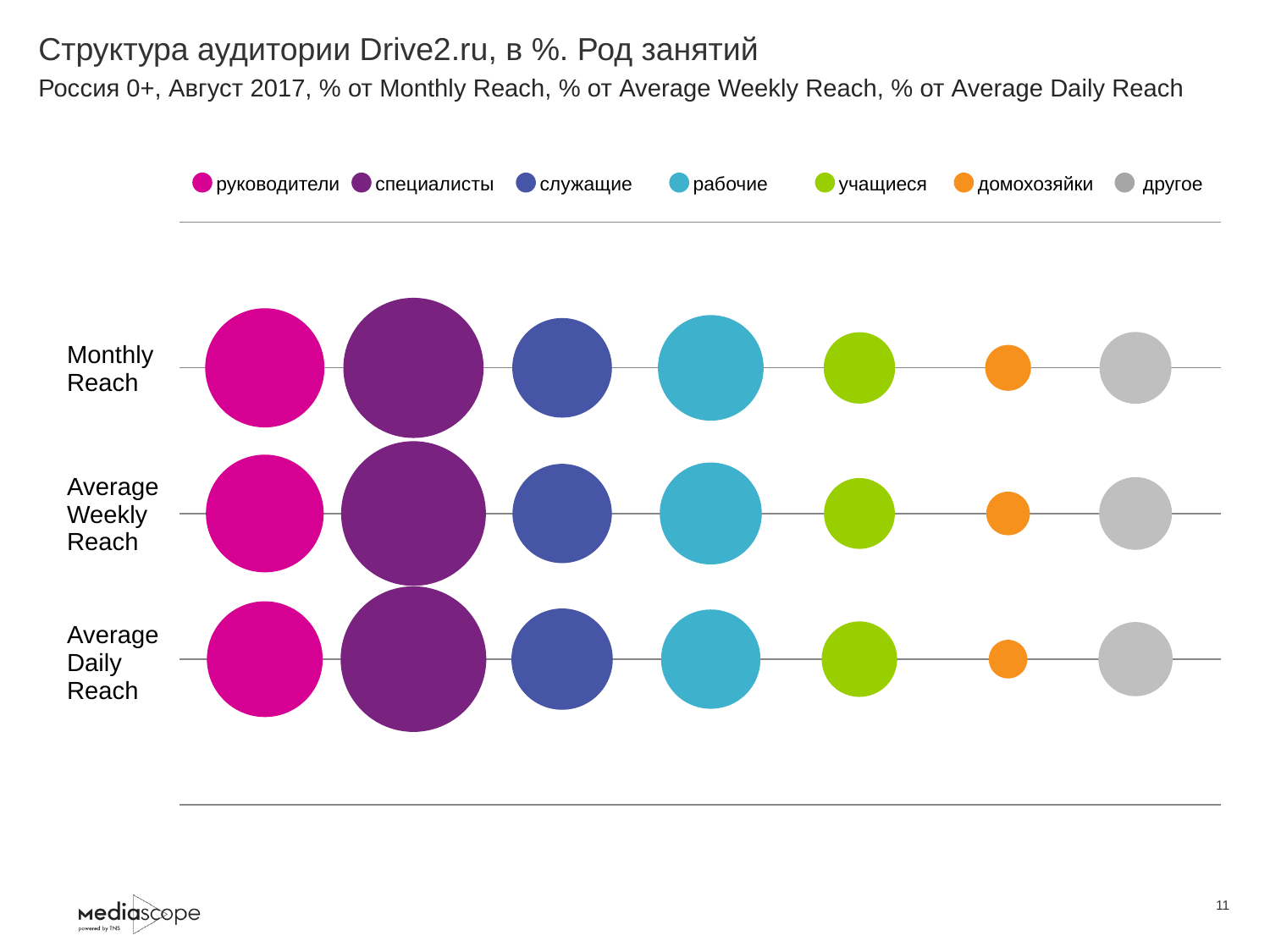
What is the title of the chart on the slide? Структура аудитории Drive2.ru, в %. Род занятий What kind of chart is shown on the slide? bubble chart Which occupation group has the largest bubble in the Monthly Reach row? специалисты In the Average Daily Reach row, which bubble is larger: рабочие or домохозяйки? рабочие How many series does the legend list? 7 In the Monthly Reach row, which bubble is larger: руководители or служащие? руководители Which occupation group has the smallest bubble in the Monthly Reach row? домохозяйки Which occupation group has the largest bubble in the Average Weekly Reach row? специалисты What colour represents the 'рабочие' series in the legend? light blue In the Average Weekly Reach row, which bubble is larger: специалисты or учащиеся? специалисты How many reach categories (rows) are plotted on the chart? 3 Which occupation group has the smallest bubble in the Average Daily Reach row? домохозяйки